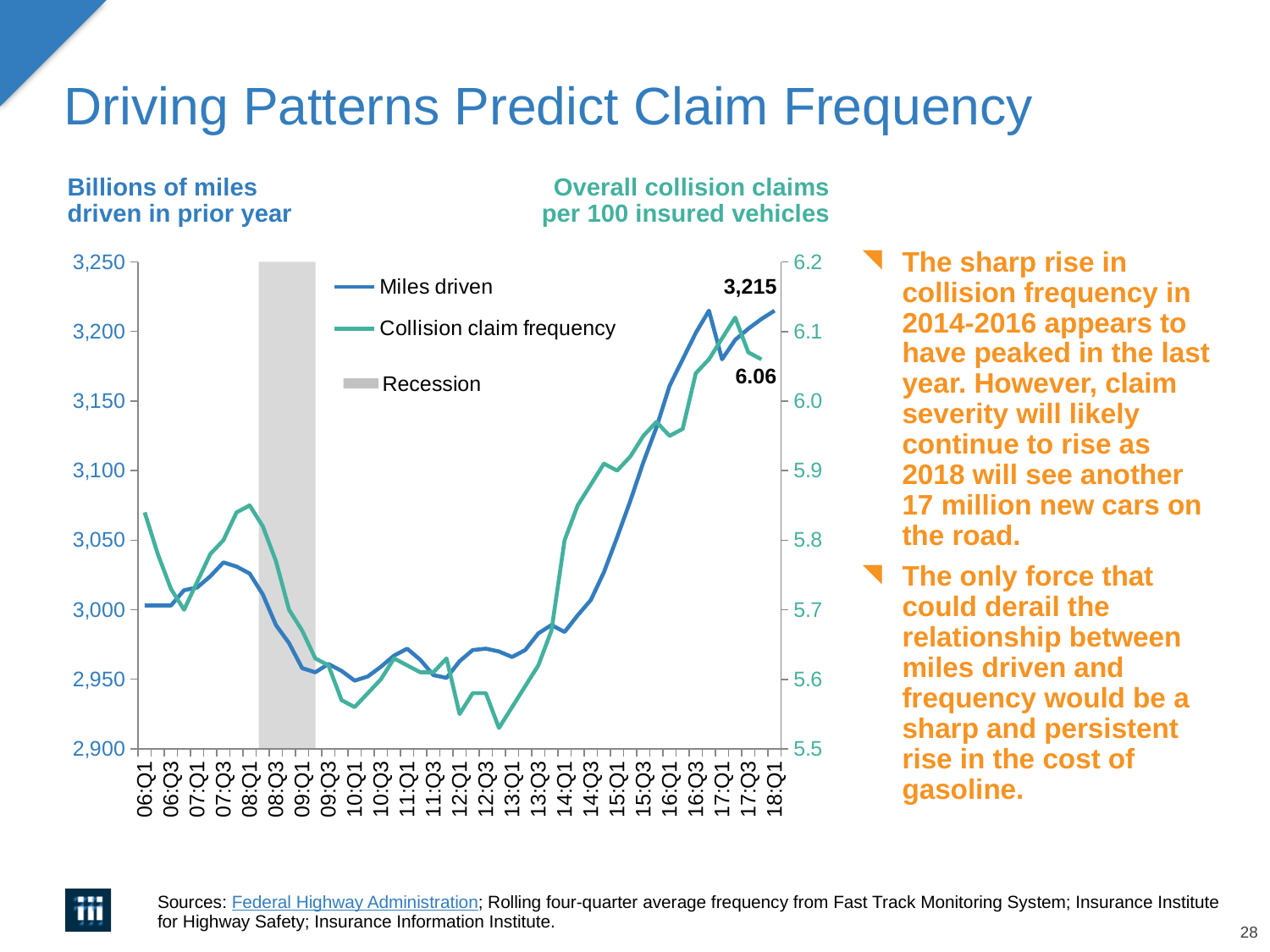
What is the value of Miles driven at 18:Q1? 3,215 What does the grey shaded area on the chart represent? Recession What kind of chart is shown on the slide? line chart In which quarter is the Collision claim frequency at its lowest? 12:Q4 How many entries does the chart legend list? 3 Is the value for Miles driven at 10:Q1 greater or less than 3,000? less Does the Miles driven line rise or fall between 14:Q1 and 16:Q3? rise Is the value for Miles driven at 06:Q1 greater or less than 3,050? less Is the value for Miles driven at 16:Q3 greater or less than 3,150? greater